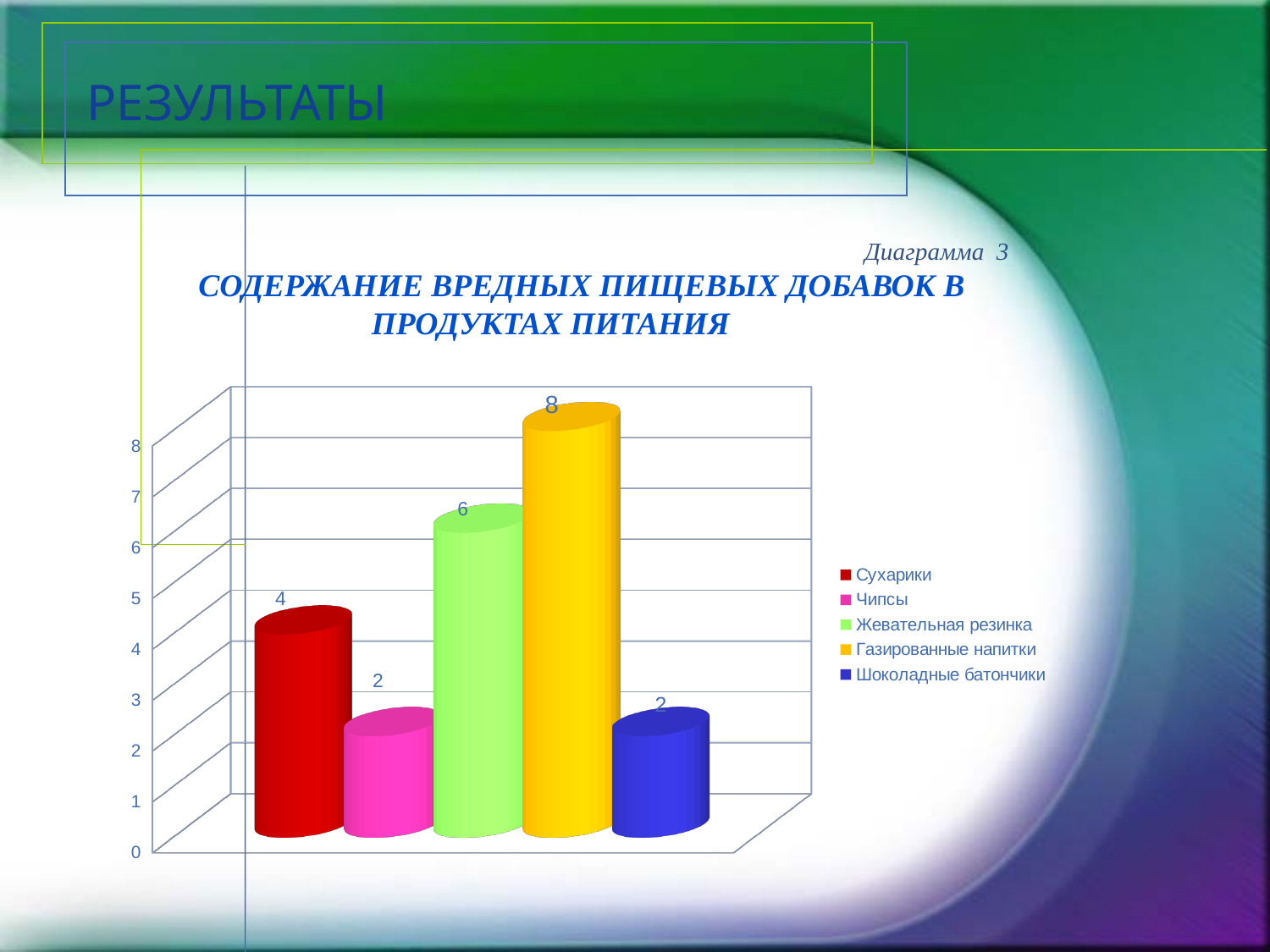
What kind of chart is shown on the slide? Bar chart What is the title of the chart? СОДЕРЖАНИЕ ВРЕДНЫХ ПИЩЕВЫХ ДОБАВОК В ПРОДУКТАХ ПИТАНИЯ Is the value for Сухарики greater or less than 3? greater What is the value for Газированные напитки? 8 What is the value for Жевательная резинка? 6 How many categories are plotted in the chart? 5 Which category has the highest value? Газированные напитки How many entries does the legend list? 5 What is the value for Сухарики? 4 What is the value for Чипсы? 2 What is the difference between the values for Газированные напитки and Сухарики? 4 Which is larger, the value for Жевательная резинка or the value for Шоколадные батончики? Жевательная резинка